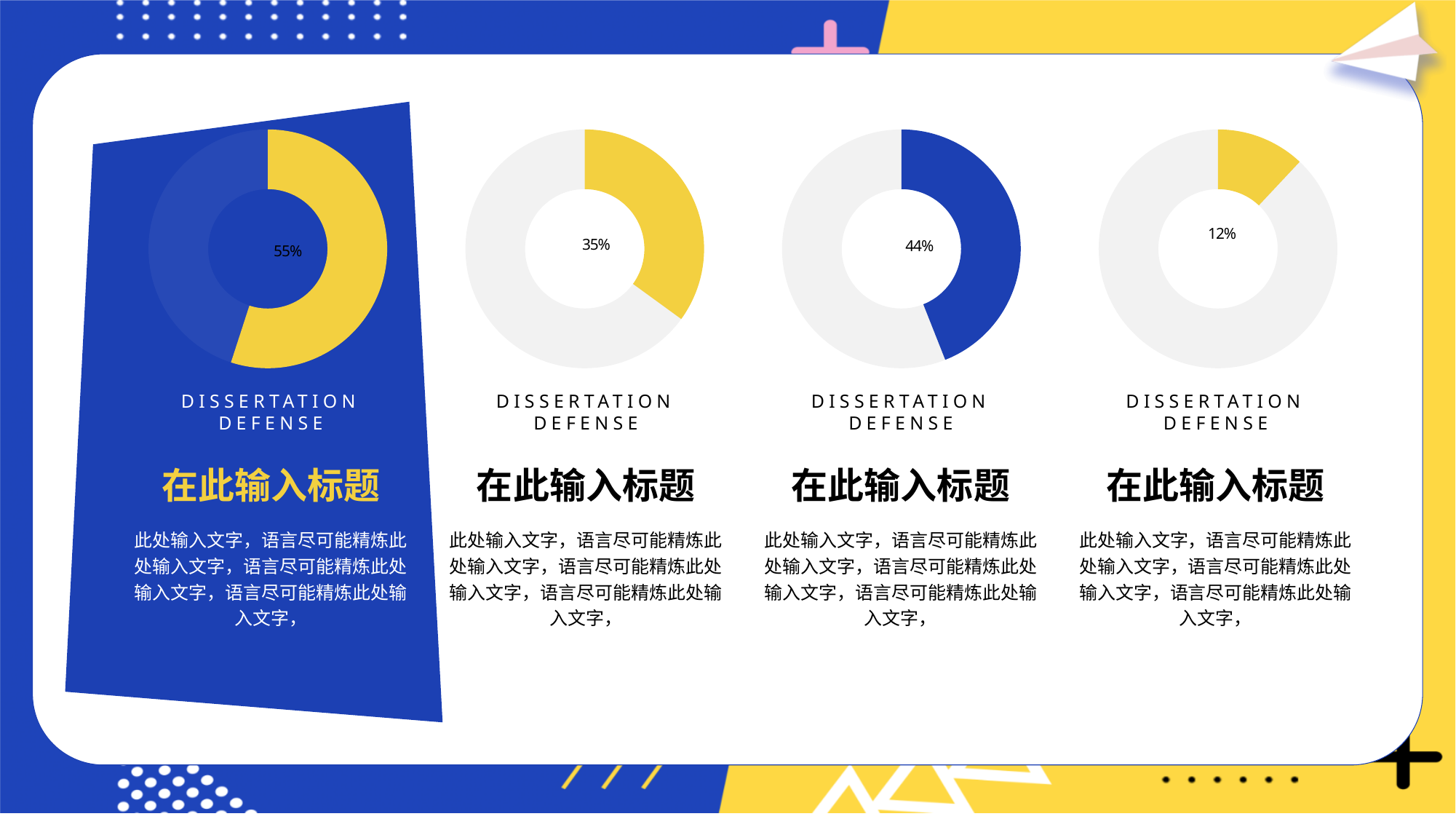
Which of the four donut charts shows the highest percentage? The leftmost chart (55%) What is the difference between the percentages shown in the third and second donut charts from the left? 9% Which is larger: the percentage in the second donut chart from the left or the percentage in the third donut chart from the left? The third chart (44%) How many donut charts are on the slide? 4 What is the difference between the percentage in the leftmost donut chart and the percentage in the rightmost donut chart? 43% What percentage is shown in the centre of the rightmost donut chart? 12% Which of the four donut charts shows the lowest percentage? The rightmost chart (12%) What percentage is shown in the centre of the second donut chart from the left? 35% What percentage is shown in the centre of the leftmost donut chart on the blue panel? 55% What percentage is shown in the centre of the third donut chart from the left? 44% What colour is the filled segment of the third donut chart from the left? Blue What kind of chart is used for each of the four figures on the slide? Donut (pie) chart